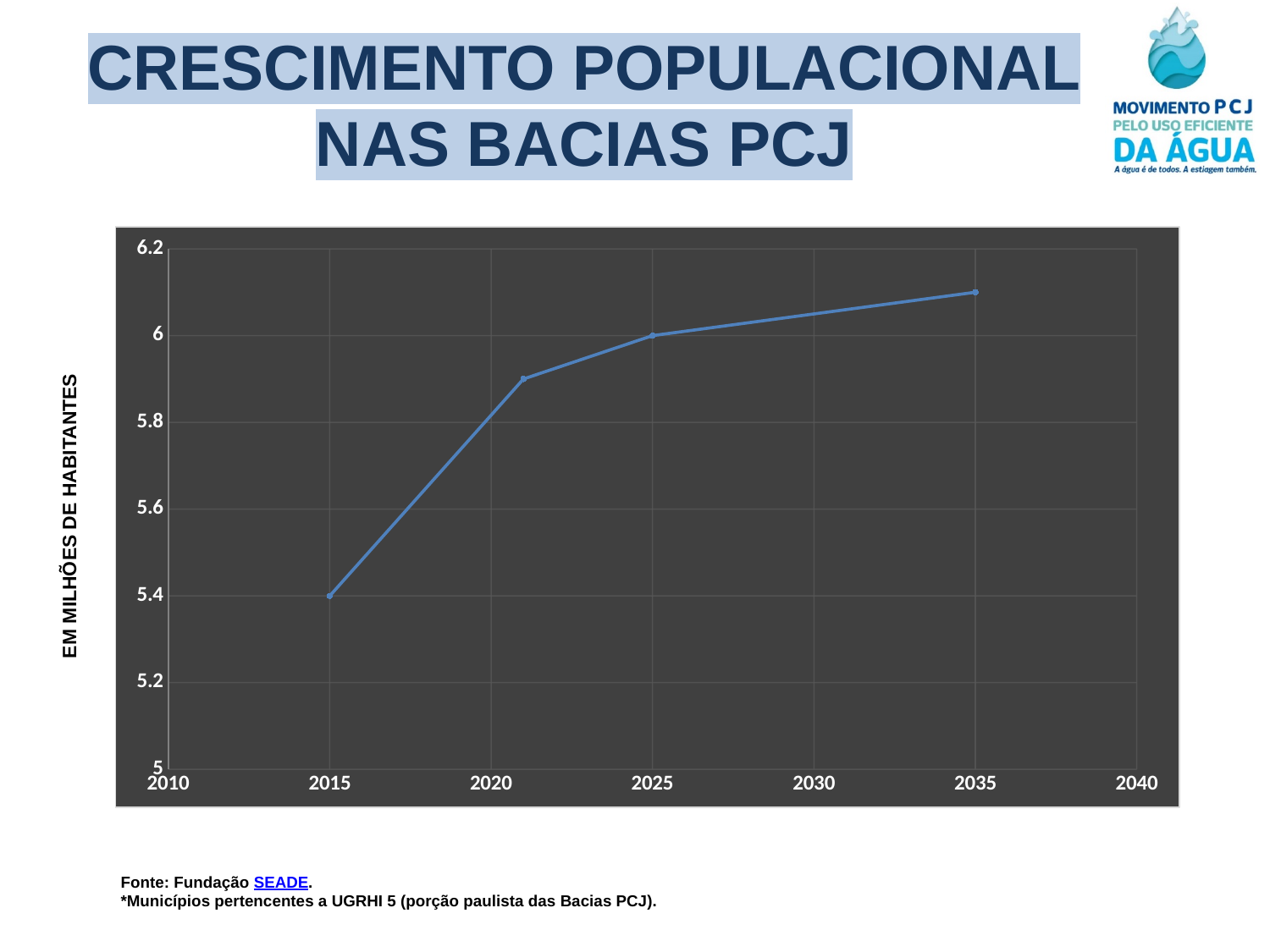
Which year has the highest value? 2035 What is the value for 2025? 6 What is the label on the vertical axis? EM MILHÕES DE HABITANTES Which is larger, the value for 2025 or the value for 2015? 2025 What kind of chart is shown on the slide? line chart What is the difference between the values for 2025 and 2015? 0.6 Do the values rise or fall from 2015 to 2035? rise Is the value for the point just after 2020 greater or less than 5.8? greater Is the value for 2035 greater or less than 6? greater How many data points are plotted on the line? 4 What is the value for 2015? 5.4 Which year has the lowest value? 2015